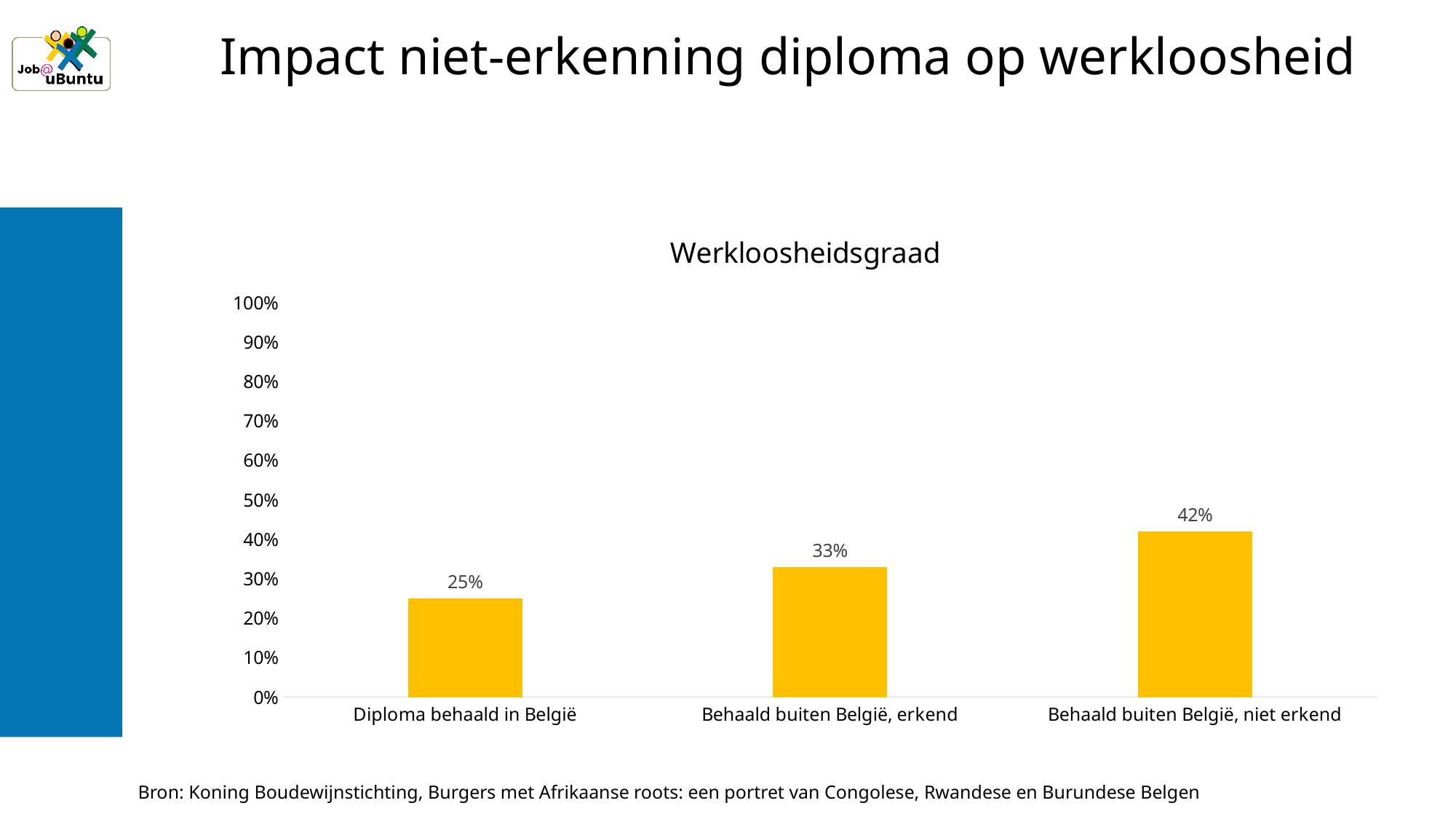
How many categories are shown in the chart? 3 What is the unemployment rate for 'Behaald buiten België, erkend'? 33% What kind of chart is shown on the slide? Bar chart What is the unemployment rate for 'Behaald buiten België, niet erkend'? 42% Which category has the lowest unemployment rate? Diploma behaald in België What is the unemployment rate for 'Diploma behaald in België'? 25% What is the difference between the unemployment rate for 'Behaald buiten België, erkend' and 'Diploma behaald in België'? 8% Which is larger: the unemployment rate for 'Behaald buiten België, erkend' or for 'Behaald buiten België, niet erkend'? Behaald buiten België, niet erkend Is the value for 'Behaald buiten België, niet erkend' greater or less than 50%? less Which category has the highest unemployment rate? Behaald buiten België, niet erkend What is the title of the chart? Werkloosheidsgraad What is the difference between the unemployment rate for 'Behaald buiten België, niet erkend' and 'Diploma behaald in België'? 17%